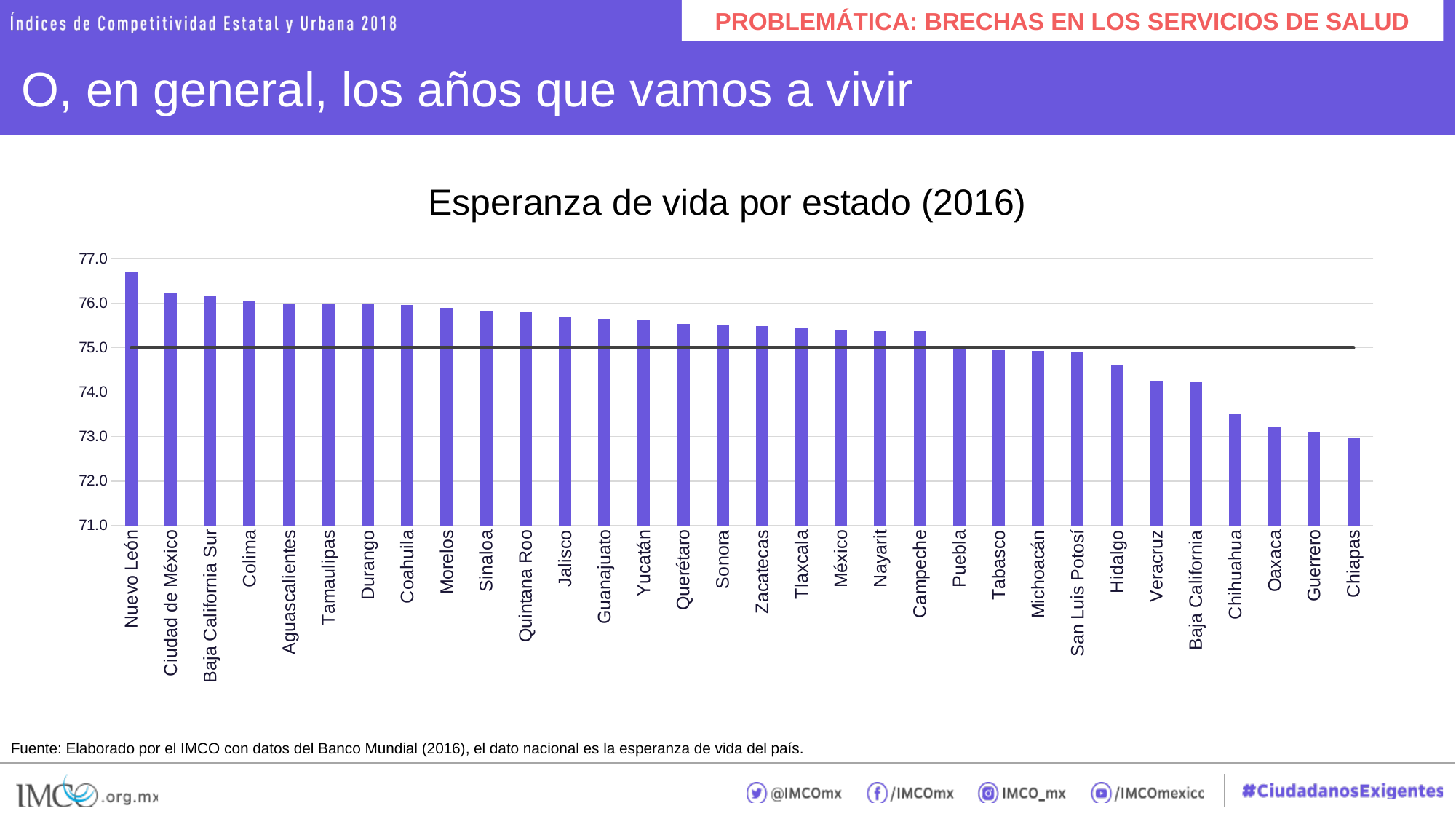
At what value on the y axis is the horizontal reference line drawn? 75.0 What is the title of the chart? Esperanza de vida por estado (2016) Which state has the highest life expectancy in the chart? Nuevo León Is the value for Nuevo León greater or less than 76.0? greater Is the value for Hidalgo greater or less than 75.0? less How many states are shown in the chart? 32 Which is larger, the value for Colima or the value for Hidalgo? Colima Is the value for Veracruz greater or less than 75.0? less What kind of chart is shown on the slide? Bar chart Do the values rise or fall from left to right along the x axis? Fall Which state has the lowest life expectancy in the chart? Chiapas